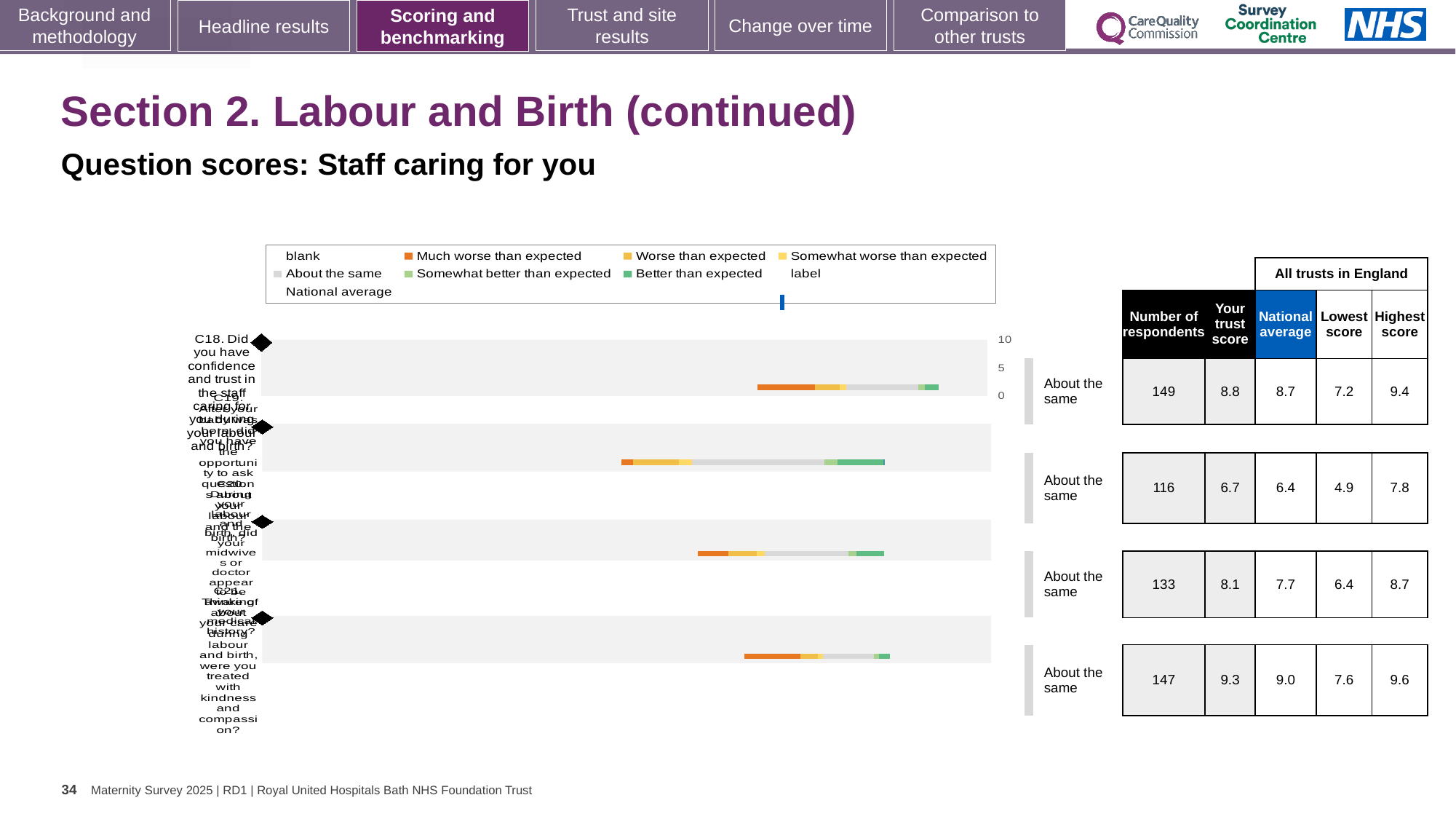
What is the highest tick value shown on the chart's score axis? 10 What colour does the legend use for 'Better than expected'? green What kind of chart is shown on the slide? bar chart In the table beside the chart, what is the national average for the bottom row (C21, treated with kindness and compassion)? 9.0 What benchmark category is shown for every row of the chart? About the same In the table beside the chart, what is the number of respondents for the top row (C18, confidence and trust in the staff)? 149 In the table beside the chart, what is 'Your trust score' for the top row (C18)? 8.8 For the top row (C18), what is the difference between 'Your trust score' and the national average in the table? 0.1 What colour does the legend use for 'Much worse than expected'? orange Which row in the table beside the chart has the highest 'Your trust score'? the bottom row (C21), 9.3 How many question rows (bars) are plotted in the chart? 4 Which row in the table beside the chart has the lowest 'Your trust score'? the second row (C19), 6.7